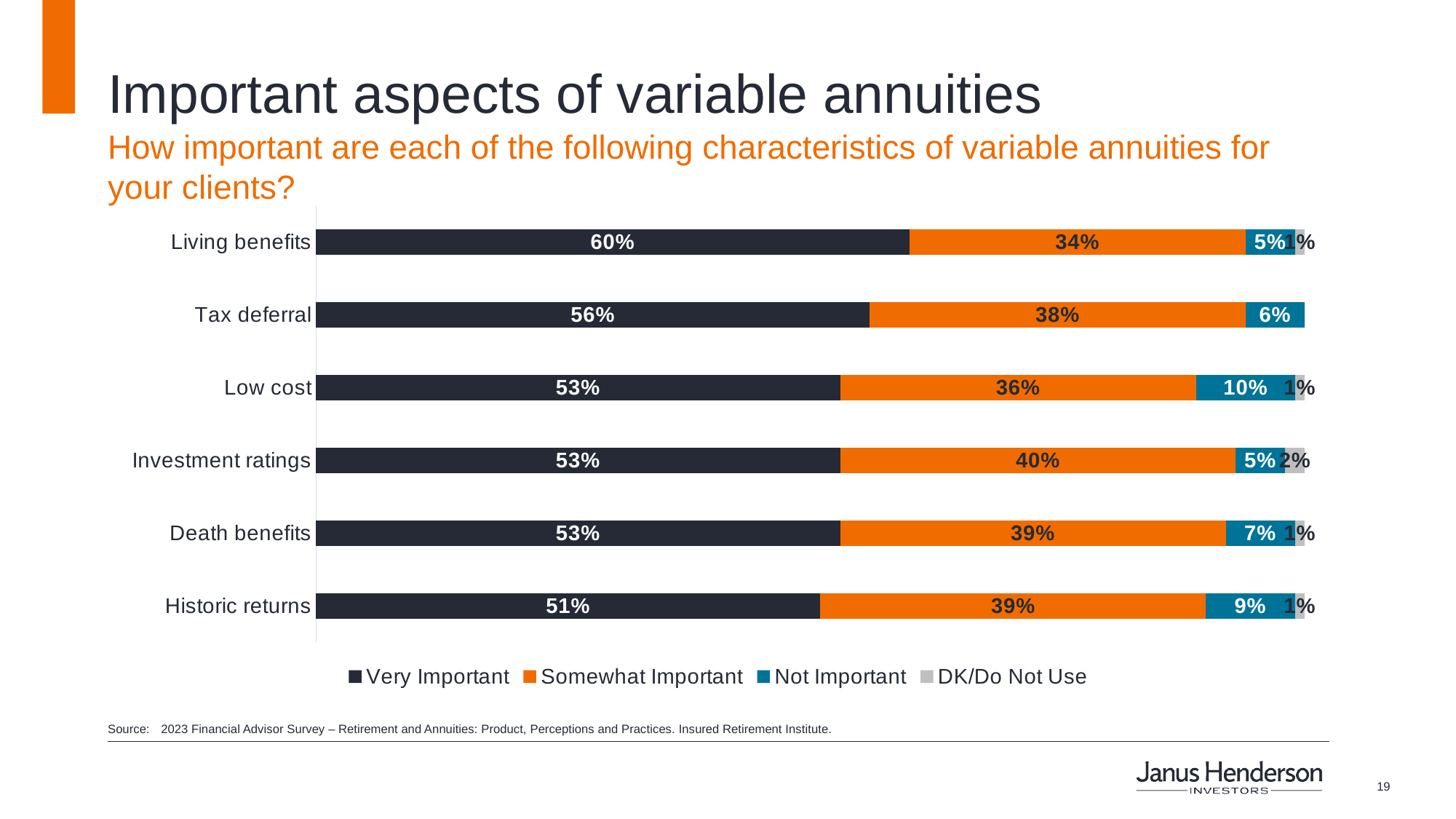
Which has a larger Not Important value, Low cost or Tax deferral? Low cost What is the total of the Very Important and Somewhat Important values for Tax deferral? 94% How many series does the legend list? 4 What is the DK/Do Not Use value for Investment ratings? 2% What is the difference between the Very Important values for Living benefits and Historic returns? 9% What is the Somewhat Important value for Investment ratings? 40% What percentage of advisors rated Living benefits as Very Important? 60% What kind of chart is shown on the slide? Stacked bar chart How many characteristics are shown in the chart? 6 What is the Not Important value for Low cost? 10% Which characteristic has the lowest Very Important percentage? Historic returns Which characteristic has the highest Very Important percentage? Living benefits